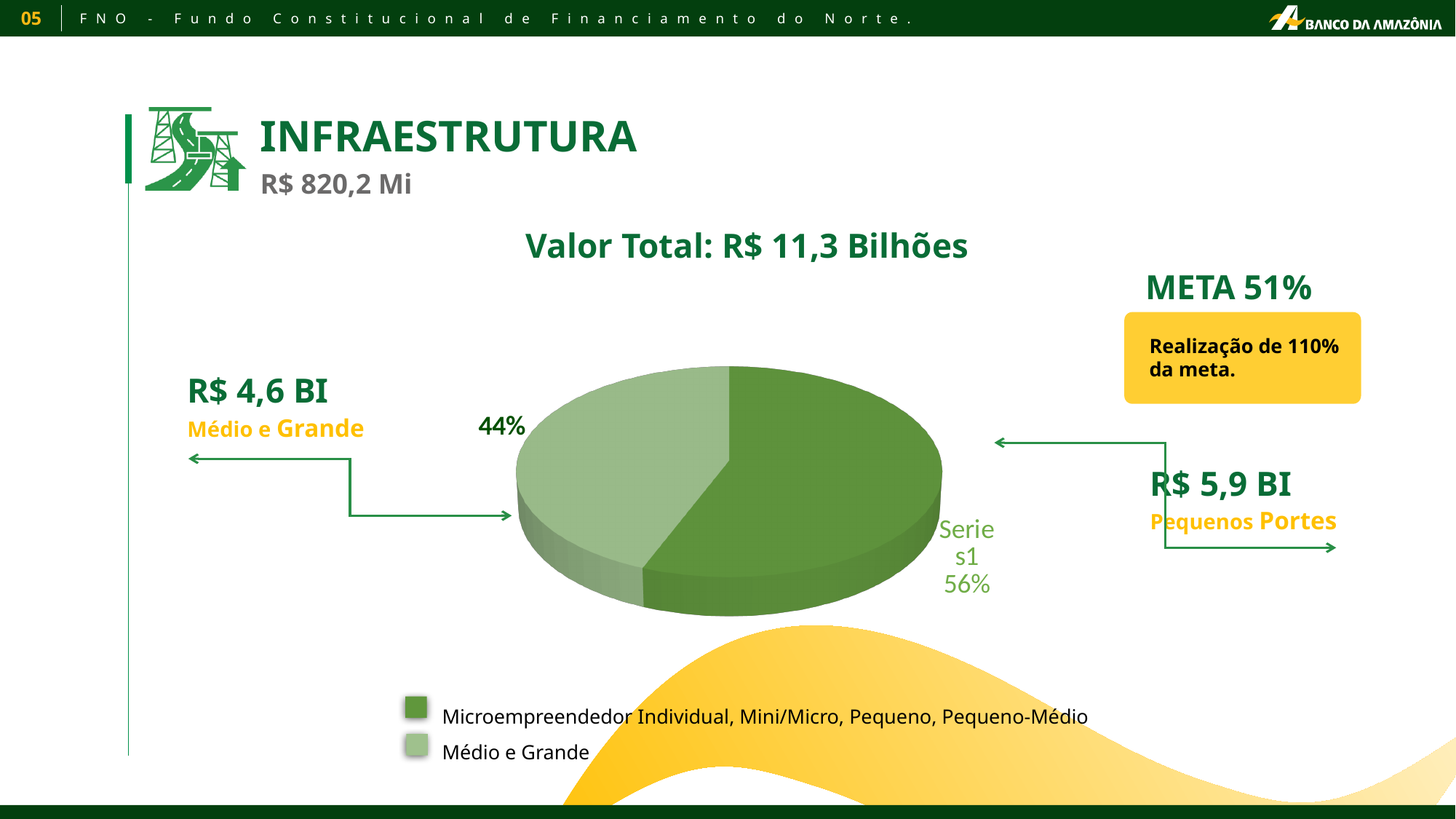
What kind of chart is shown on the slide? pie chart What total value is stated above the pie chart? R$ 11,3 Bilhões What value in R$ is annotated next to the 'Médio e Grande' slice? R$ 4,6 BI How many entries does the legend of the pie chart list? 2 Which slice of the pie chart is the smallest? Médio e Grande What is the difference in percentage points between the 56% slice and the 44% slice? 12 What share of the pie does the 'Médio e Grande' slice represent? 44% Which slice of the pie chart is the largest? Microempreendedor Individual, Mini/Micro, Pequeno, Pequeno-Médio How many slices does the pie chart have? 2 Which is larger: the 'Médio e Grande' slice or the 'Microempreendedor Individual, Mini/Micro, Pequeno, Pequeno-Médio' slice? Microempreendedor Individual, Mini/Micro, Pequeno, Pequeno-Médio What share of the pie does the 'Microempreendedor Individual, Mini/Micro, Pequeno, Pequeno-Médio' slice represent? 56% What value in R$ is annotated for 'Pequenos Portes' next to the pie chart? R$ 5,9 BI